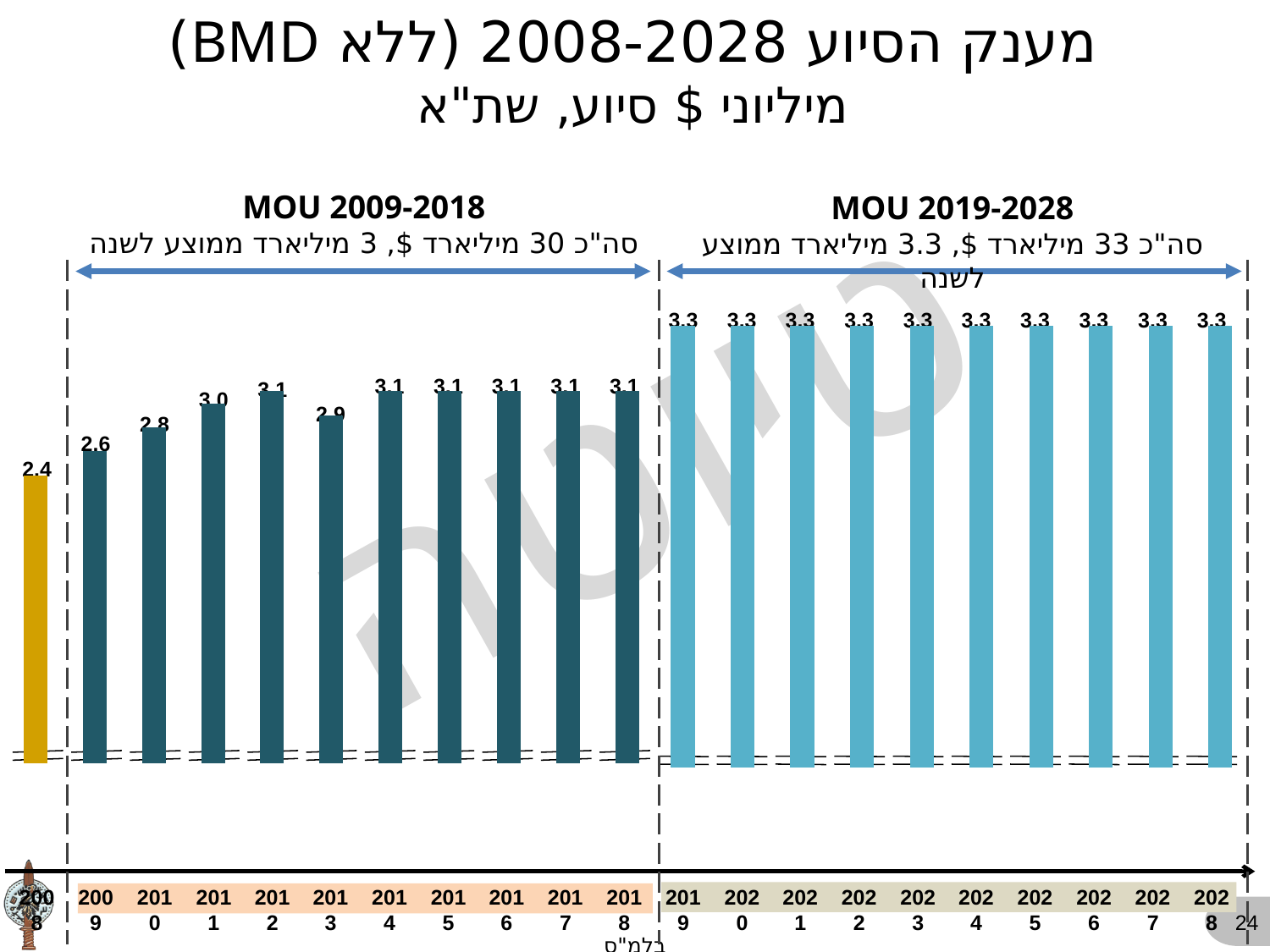
How many years (bars) are shown on the chart? 21 What kind of chart is shown on the slide? bar chart What is the value for 2024? 3.3 Which is larger, the value for 2012 or the value for 2013? 2012 What is the difference between the values for 2019 and 2018? 0.2 What is the value for 2008? 2.4 What is the label of the MOU period covering the light blue bars? MOU 2019-2028 What is the value for 2013? 2.9 Which year has the lowest value? 2008 What is the value for 2010? 2.8 Do the values generally rise or fall from 2008 to 2028? rise What is the difference between the values for 2011 and 2008? 0.6